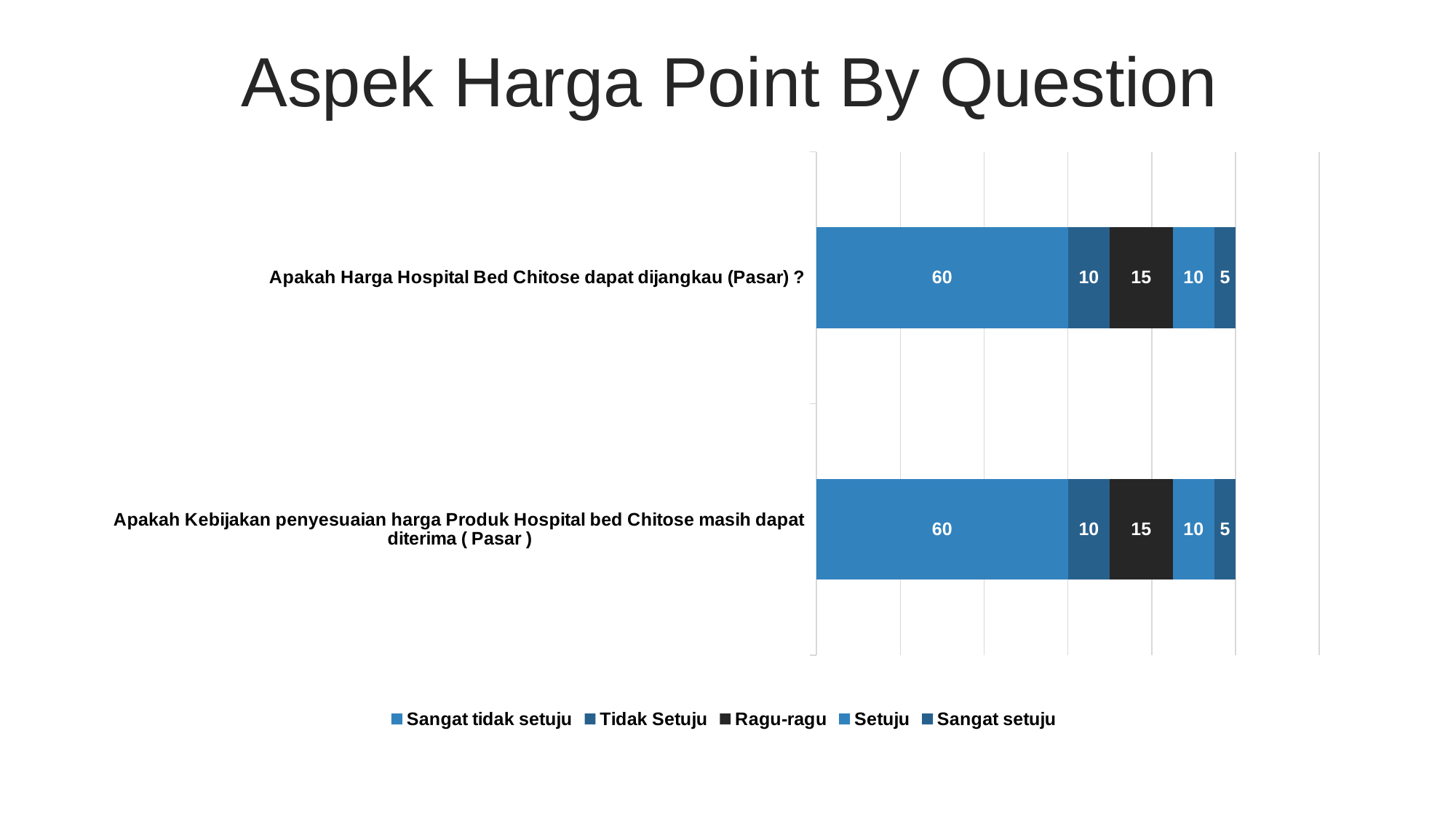
What is the value of "Sangat setuju" for "Apakah Harga Hospital Bed Chitose dapat dijangkau (Pasar) ?"? 5 What is the value of "Ragu-ragu" for "Apakah Kebijakan penyesuaian harga Produk Hospital bed Chitose masih dapat diterima ( Pasar )"? 15 What is the difference between "Sangat tidak setuju" and "Ragu-ragu" for "Apakah Harga Hospital Bed Chitose dapat dijangkau (Pasar) ?"? 45 What is the total of the stacked bar for "Apakah Kebijakan penyesuaian harga Produk Hospital bed Chitose masih dapat diterima ( Pasar )"? 100 What is the title of the slide? Aspek Harga Point By Question What is the value of "Tidak Setuju" for "Apakah Kebijakan penyesuaian harga Produk Hospital bed Chitose masih dapat diterima ( Pasar )"? 10 What kind of chart is shown on the slide? Stacked bar chart How many categories (questions) are plotted on the chart? 2 Which series has the highest value for "Apakah Harga Hospital Bed Chitose dapat dijangkau (Pasar) ?"? Sangat tidak setuju How many series does the legend list? 5 Which series has the lowest value for "Apakah Kebijakan penyesuaian harga Produk Hospital bed Chitose masih dapat diterima ( Pasar )"? Sangat setuju What is the value of "Sangat tidak setuju" for "Apakah Harga Hospital Bed Chitose dapat dijangkau (Pasar) ?"? 60